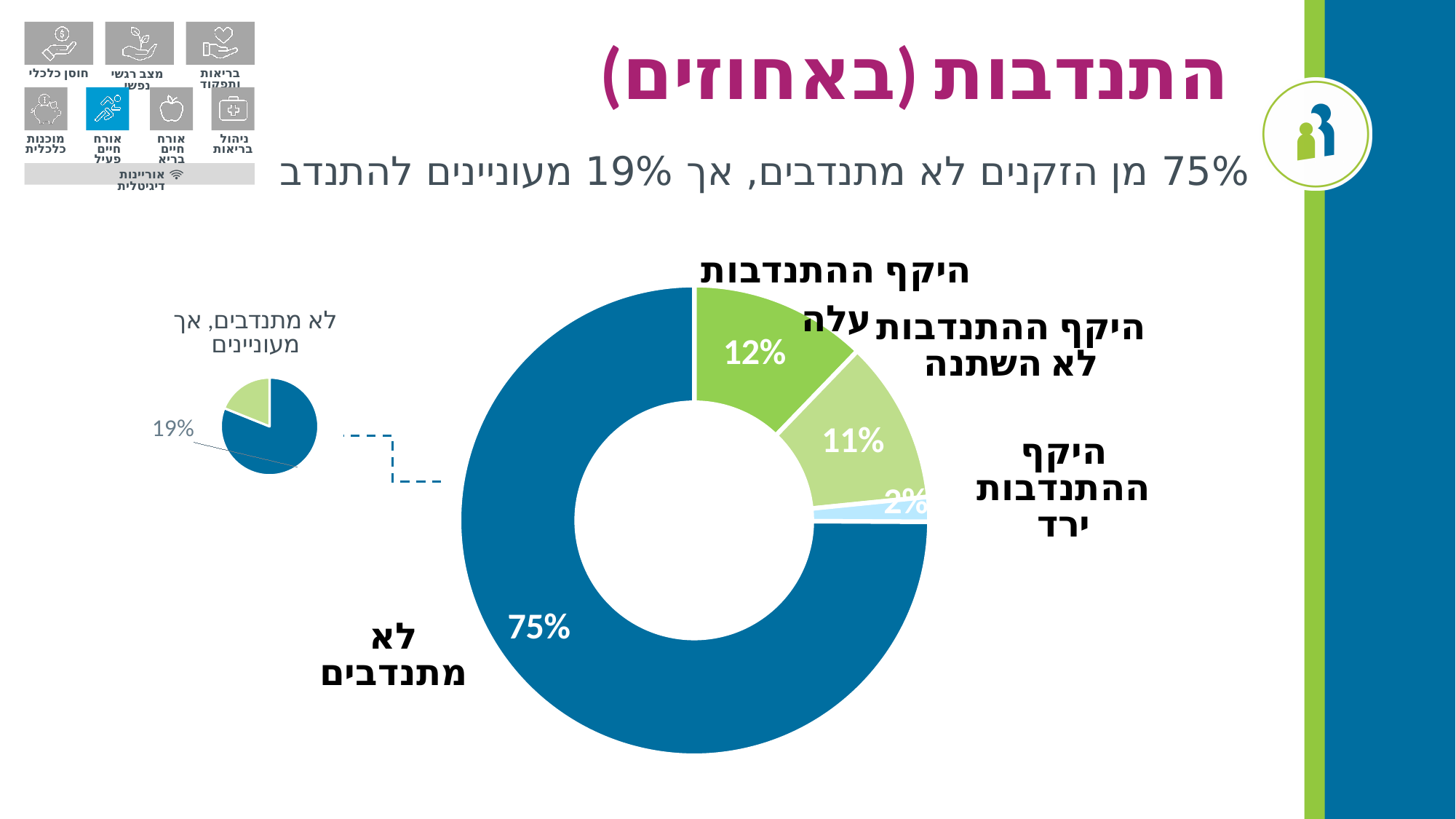
In the large donut chart, what percentage is shown for "היקף ההתנדבות עלה"? 12% In the large donut chart, what percentage is shown for "היקף ההתנדבות ירד"? 2% In the large donut chart, what percentage is shown for "היקף ההתנדבות לא השתנה"? 11% In the small pie chart on the left, what percentage is shown for "לא מתנדבים, אך מעוניינים"? 19% In the large donut chart, which slice is the largest? לא מתנדבים In the large donut chart, which slice is the smallest? היקף ההתנדבות ירד How many slices does the large donut chart have? 4 In the large donut chart, which is larger: "היקף ההתנדבות עלה" or "היקף ההתנדבות לא השתנה"? היקף ההתנדבות עלה In the large donut chart, what is the difference in percentage points between "לא מתנדבים" and "היקף ההתנדבות עלה"? 63 What kind of chart is the large chart in the centre of the slide? Donut (pie) chart What is the title of the slide containing the charts? התנדבות (באחוזים) In the large donut chart, what percentage is shown for the slice labelled "לא מתנדבים"? 75%